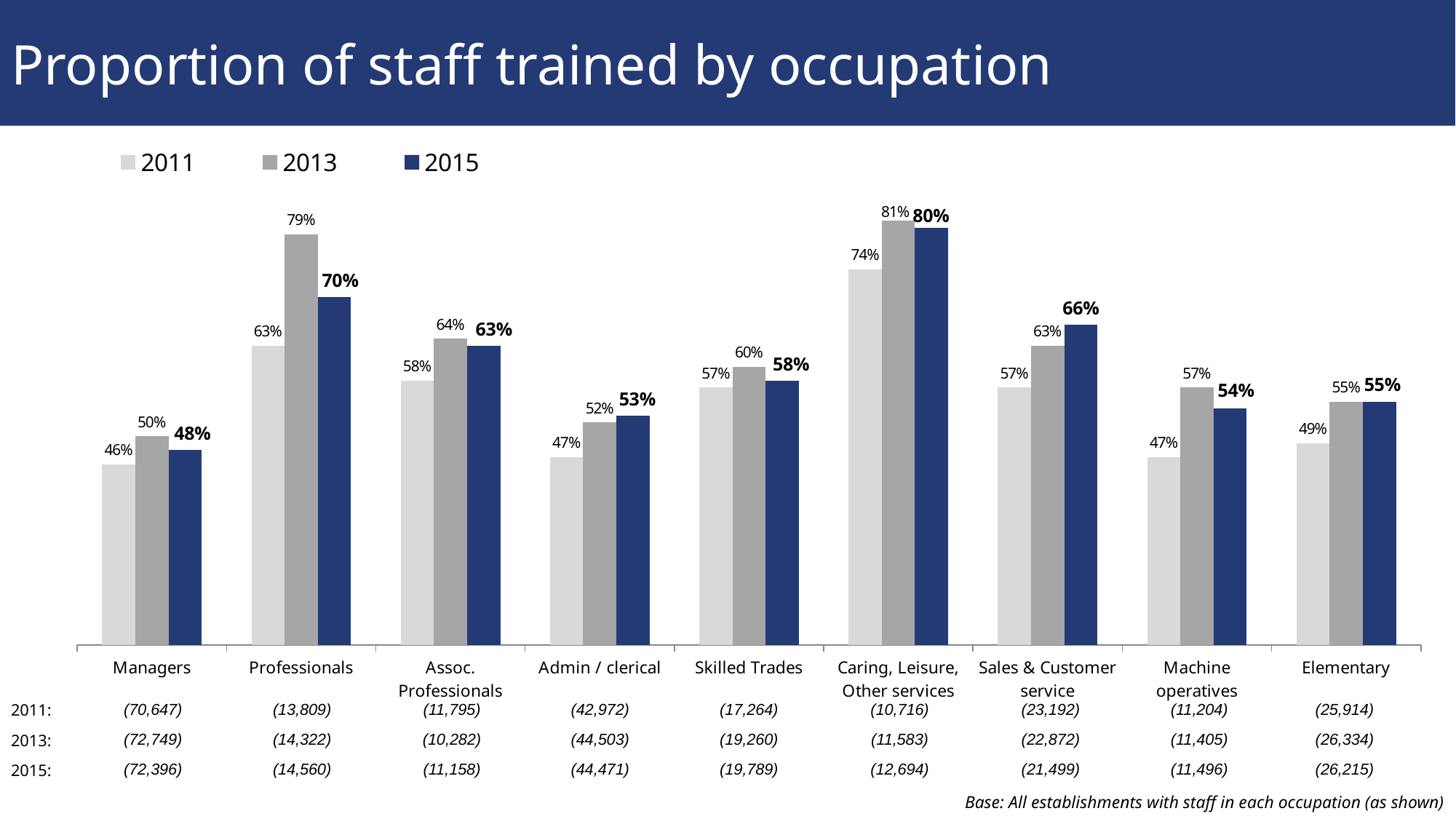
How many series does the legend list? 3 What is the proportion of Professionals trained in 2015? 70% What kind of chart is shown on the slide? Bar chart Which is larger for Admin / clerical: the 2011 value or the 2015 value? 2015 Which occupation has the highest proportion of staff trained in 2015? Caring, Leisure, Other services What is the 2013 value for Sales & Customer service? 63% What is the proportion of Managers trained in 2011? 46% Did the proportion of Machine operatives trained rise or fall from 2013 to 2015? Fall Which occupation has the lowest proportion of staff trained in 2015? Managers What is the title of the chart? Proportion of staff trained by occupation What is the difference between the 2013 and 2015 values for Professionals? 9 percentage points How many occupation categories are shown on the chart? 9